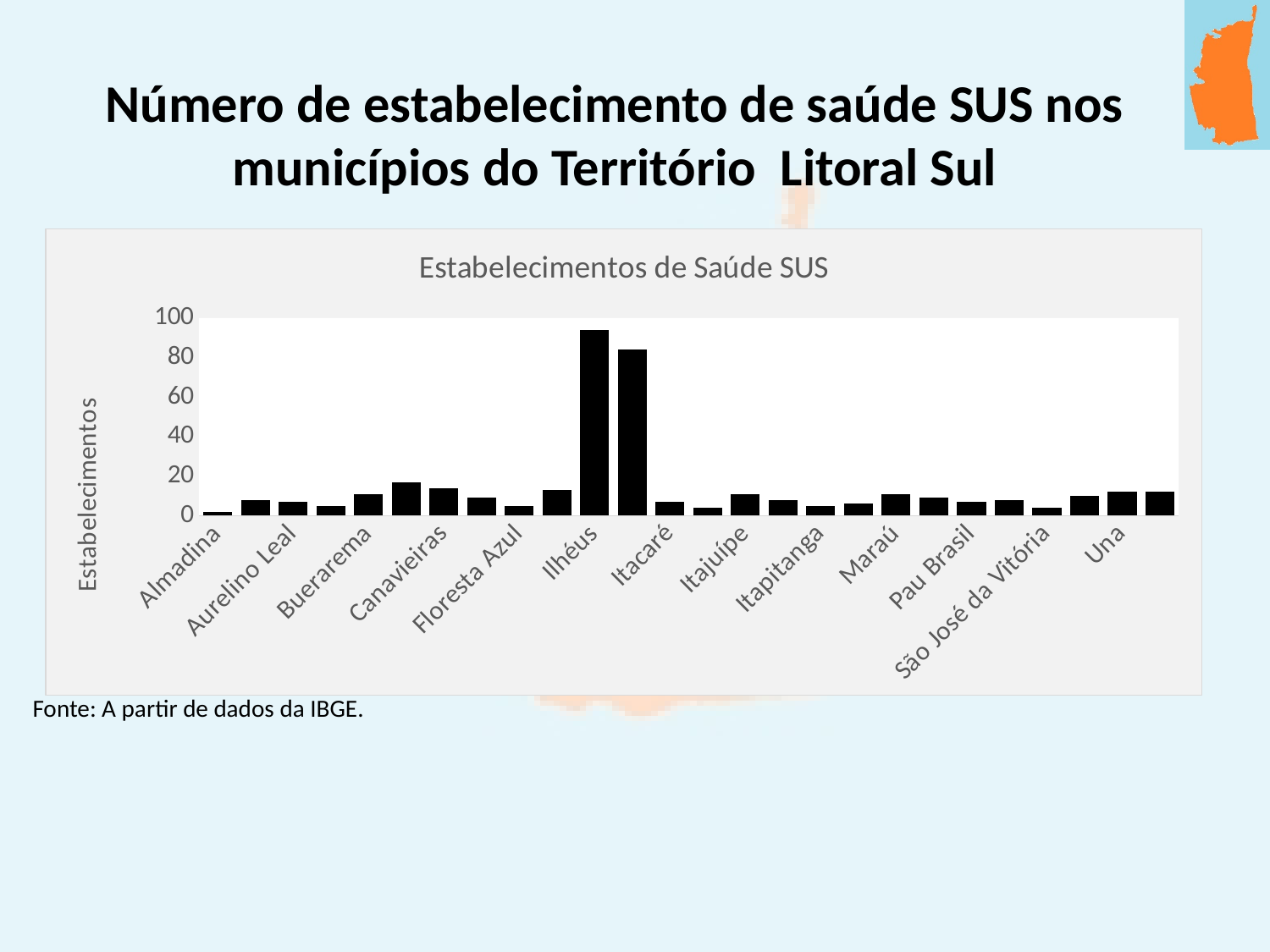
Is the value for Ilhéus greater or less than 80? greater Which municipality has the highest number of SUS health establishments? Ilhéus Which has more SUS health establishments, Ilhéus or Maraú? Ilhéus What is the title of the chart? Estabelecimentos de Saúde SUS What is the label on the vertical axis of the chart? Estabelecimentos Is the value for Una greater or less than 40? less Is the value for Canavieiras greater or less than 20? less Which has more SUS health establishments, Ilhéus or Itacaré? Ilhéus What kind of chart is shown on the slide? bar chart Which labelled municipality has the lowest number of SUS health establishments? Almadina Which has more SUS health establishments, Canavieiras or Floresta Azul? Canavieiras